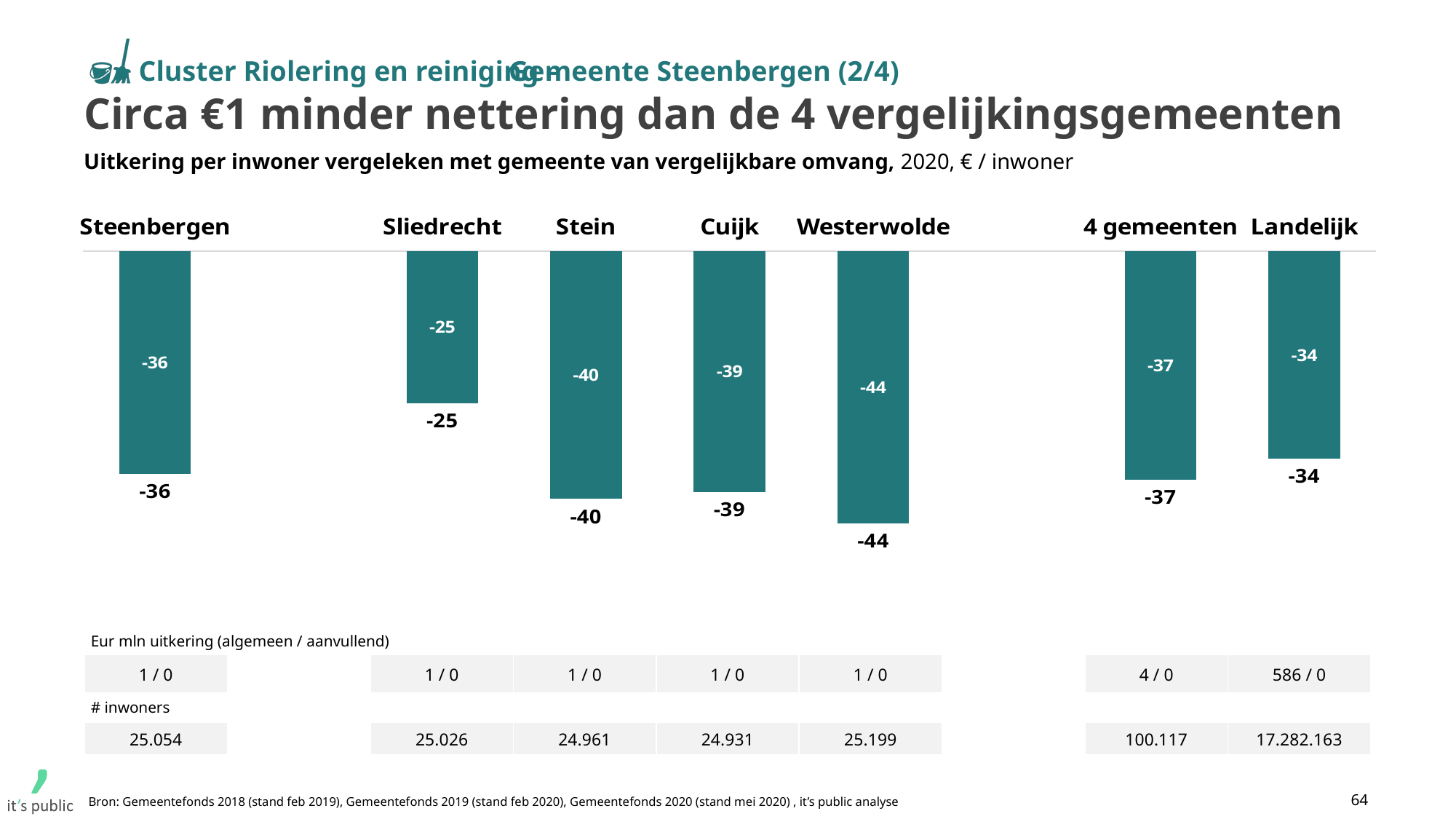
What is the value for Westerwolde? -44 What is the value for 4 gemeenten? -37 What unit is stated in the chart subtitle for the values? € / inwoner What is the value for Steenbergen? -36 What is the difference between the values for Sliedrecht and Westerwolde? 19 What kind of chart is shown on the slide? Bar chart How many bars are shown in the chart? 7 What is the value for Landelijk? -34 What is the difference between the values for Steenbergen and 4 gemeenten? 1 Which category has the highest (least negative) value? Sliedrecht Which category has the lowest (most negative) value? Westerwolde Which has the more negative value, Stein or Cuijk? Stein